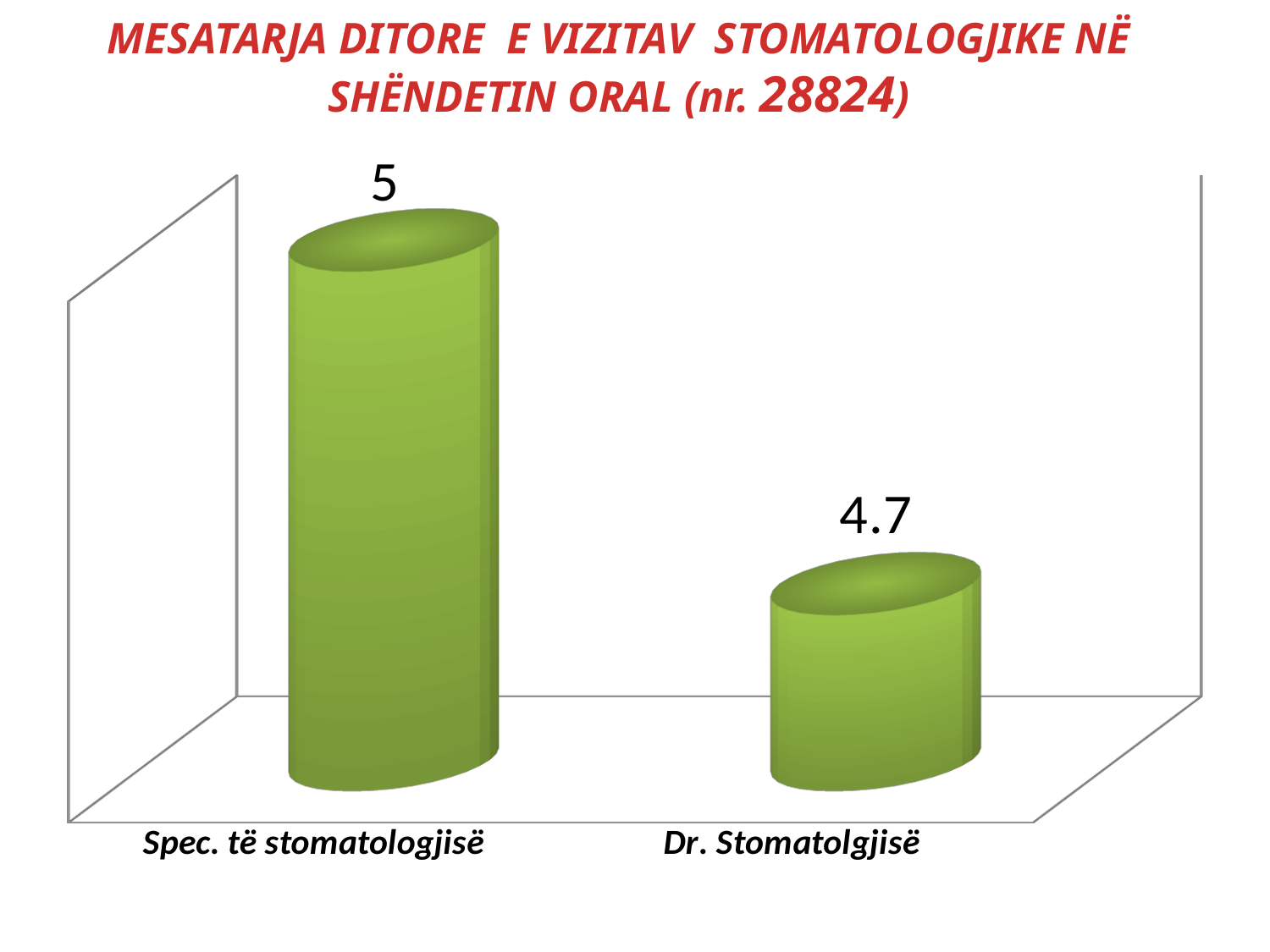
What colour are the bars in the chart? Green Which category has the highest value? Spec. të stomatologjisë How many categories are shown in the chart? 2 What is the value for Spec. të stomatologjisë? 5 What is the value for Dr. Stomatolgjisë? 4.7 What is the difference between the values for Spec. të stomatologjisë and Dr. Stomatolgjisë? 0.3 What kind of chart is shown on the slide? Bar chart Do the values rise or fall from left to right across the categories? Fall Which category has the lowest value? Dr. Stomatolgjisë What number is given in parentheses in the chart title? 28824 Which is larger, the value for Spec. të stomatologjisë or the value for Dr. Stomatolgjisë? Spec. të stomatologjisë